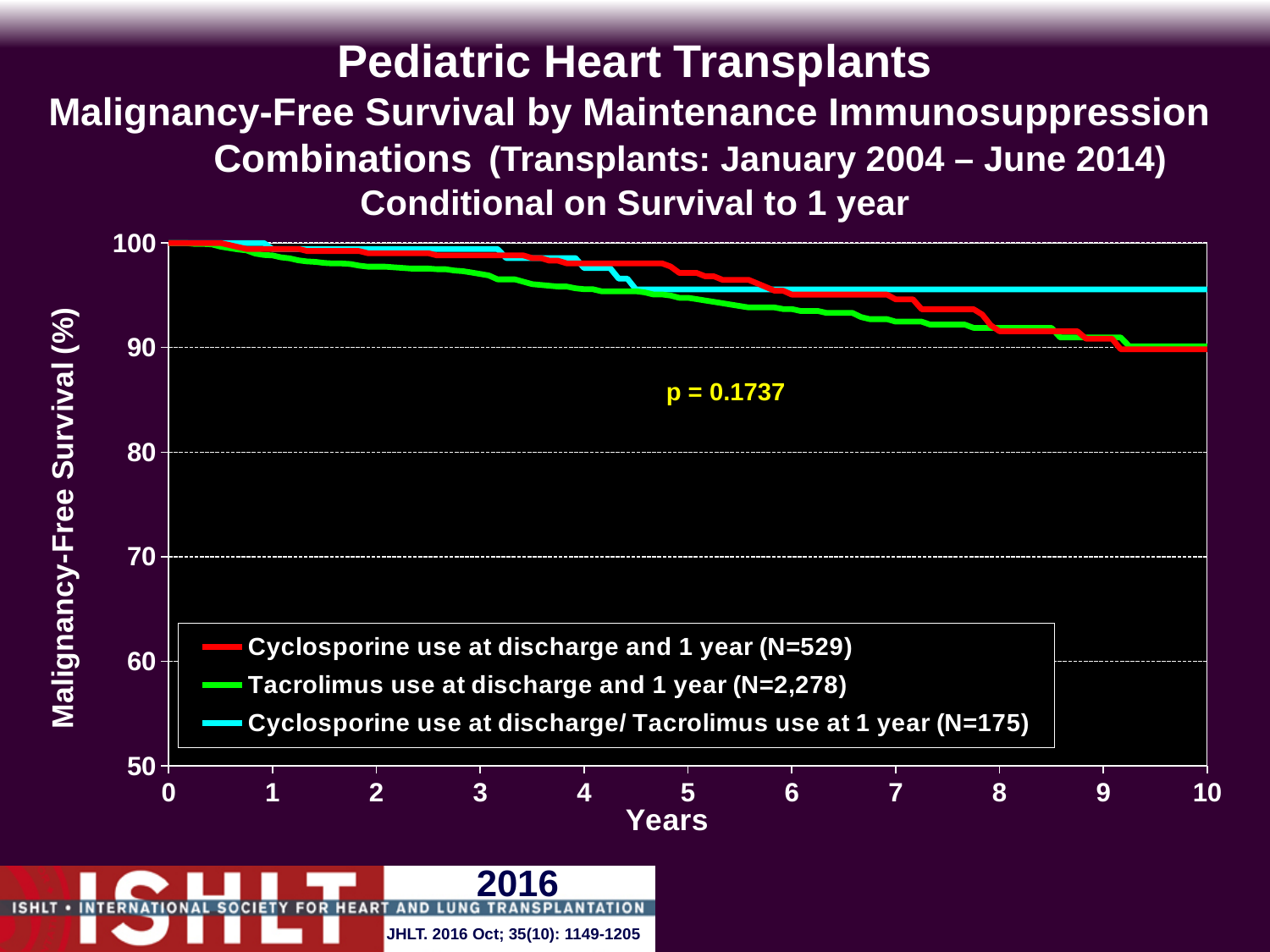
What p-value is printed on the chart? p = 0.1737 At year 8, is the value for 'Cyclosporine use at discharge and 1 year' greater or less than 80? greater What kind of chart is shown on the slide? line chart At year 10, is the value for 'Cyclosporine use at discharge/ Tacrolimus use at 1 year' greater or less than 90? greater Do the survival curves rise or fall as years increase? fall How many year tick marks are labelled on the x axis? 11 At year 10, which is higher: the 'Cyclosporine use at discharge and 1 year' curve or the 'Cyclosporine use at discharge/ Tacrolimus use at 1 year' curve? Cyclosporine use at discharge/ Tacrolimus use at 1 year At year 10, which series has the highest malignancy-free survival? Cyclosporine use at discharge/ Tacrolimus use at 1 year At year 5, is the value for 'Tacrolimus use at discharge and 1 year' greater or less than 90? greater At year 7, which is higher: the 'Cyclosporine use at discharge and 1 year' curve or the 'Tacrolimus use at discharge and 1 year' curve? Cyclosporine use at discharge and 1 year How many series does the legend list? 3 What is the N for the 'Tacrolimus use at discharge and 1 year' group in the legend? N=2,278